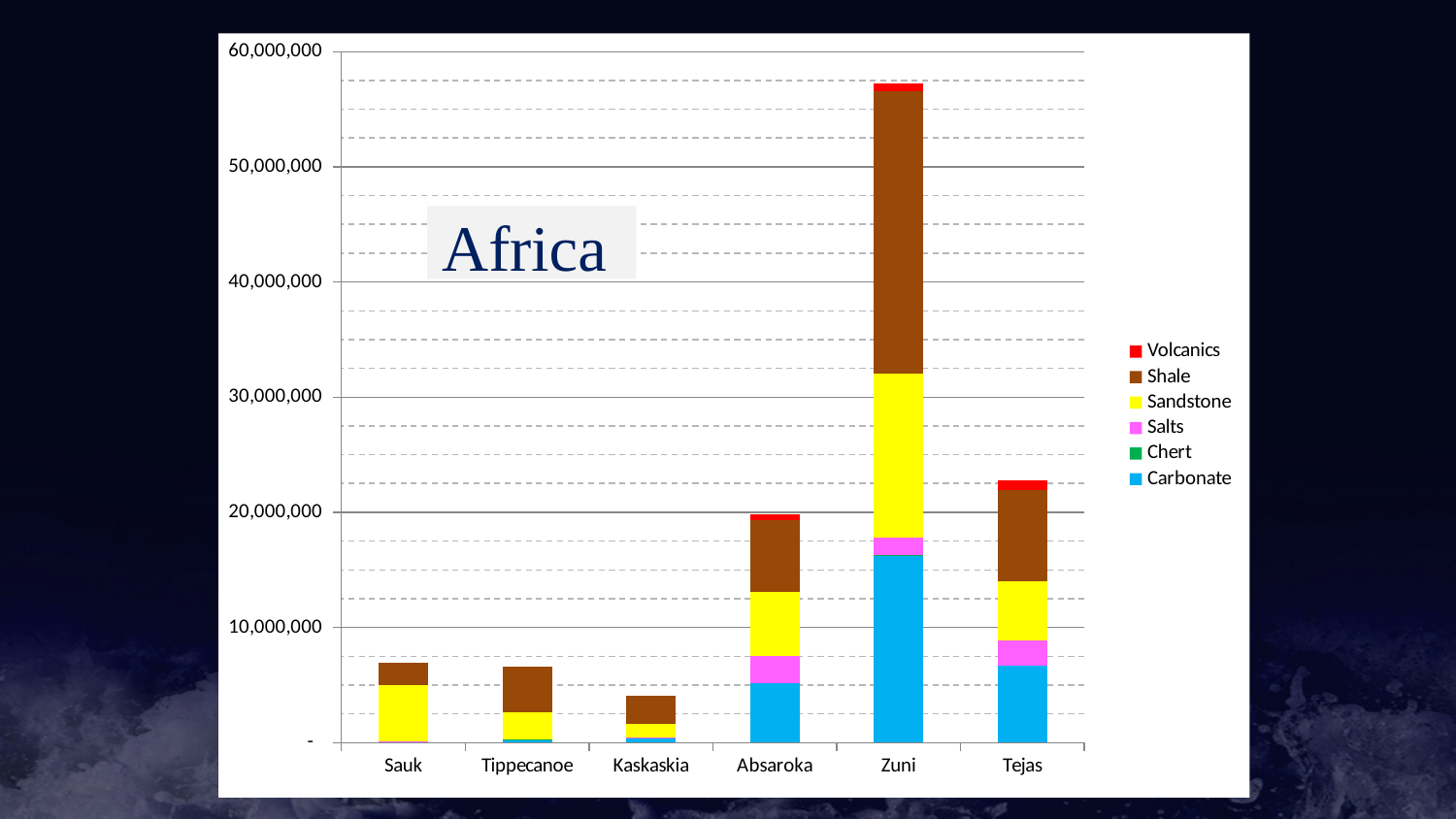
Is the total value for Zuni greater or less than 50,000,000? greater Which stacked bar is taller, Absaroka or Tejas? Tejas Is the total value for Tejas greater or less than 20,000,000? greater How many categories are shown on the x axis of the chart? 6 Which stacked bar is taller, Zuni or Absaroka? Zuni What is the title of the chart? Africa How many series does the legend list? 6 Which category has the tallest stacked bar? Zuni What kind of chart is shown on the slide? Stacked bar chart Is the total value for Sauk greater or less than 10,000,000? less Which category has the shortest stacked bar? Kaskaskia Which series is listed first (at the top) in the legend? Volcanics